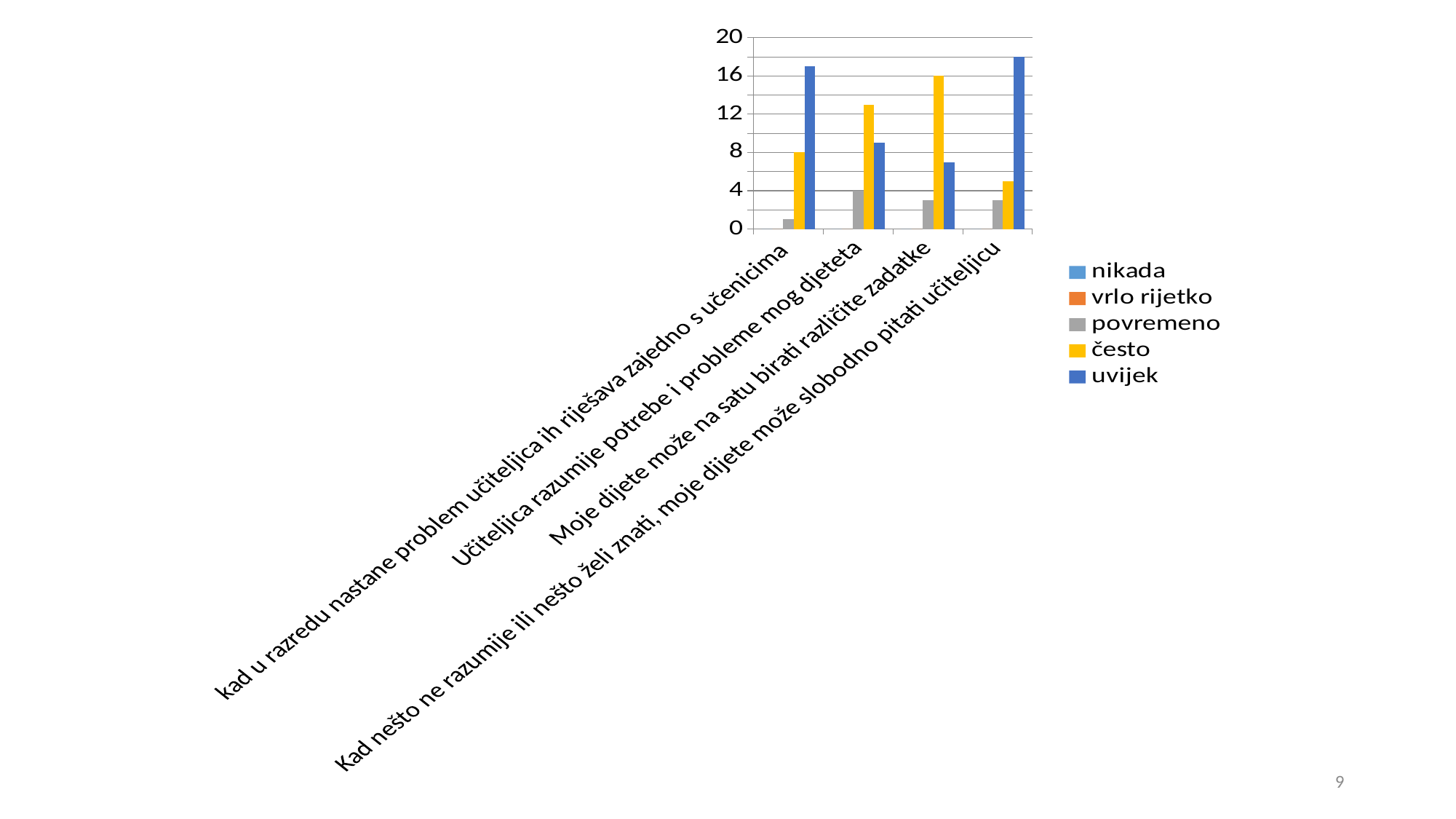
What kind of chart is shown on the slide? bar chart For 'Moje dijete može na satu birati različite zadatke', which is larger: 'povremeno' or 'uvijek'? uvijek For 'Učiteljica razumije potrebe i probleme mog djeteta', which is larger: 'često' or 'uvijek'? često Which series has the highest value for the category 'Moje dijete može na satu birati različite zadatke'? često Which category has the lowest value for the 'uvijek' series? Moje dijete može na satu birati različite zadatke Is the value of 'često' for 'Učiteljica razumije potrebe i probleme mog djeteta' greater or less than 12? greater What colour are the bars for the 'često' series? yellow How many series does the legend list? 5 Which series has the highest value for the category 'Kad nešto ne razumije ili nešto želi znati, moje dijete može slobodno pitati učiteljicu'? uvijek Is the value of 'često' for 'Kad nešto ne razumije ili nešto želi znati, moje dijete može slobodno pitati učiteljicu' greater or less than 8? less Is the value of 'uvijek' for 'kad u razredu nastane problem učiteljica ih rješava zajedno s učenicima' greater or less than 16? greater How many categories are shown on the x axis? 4